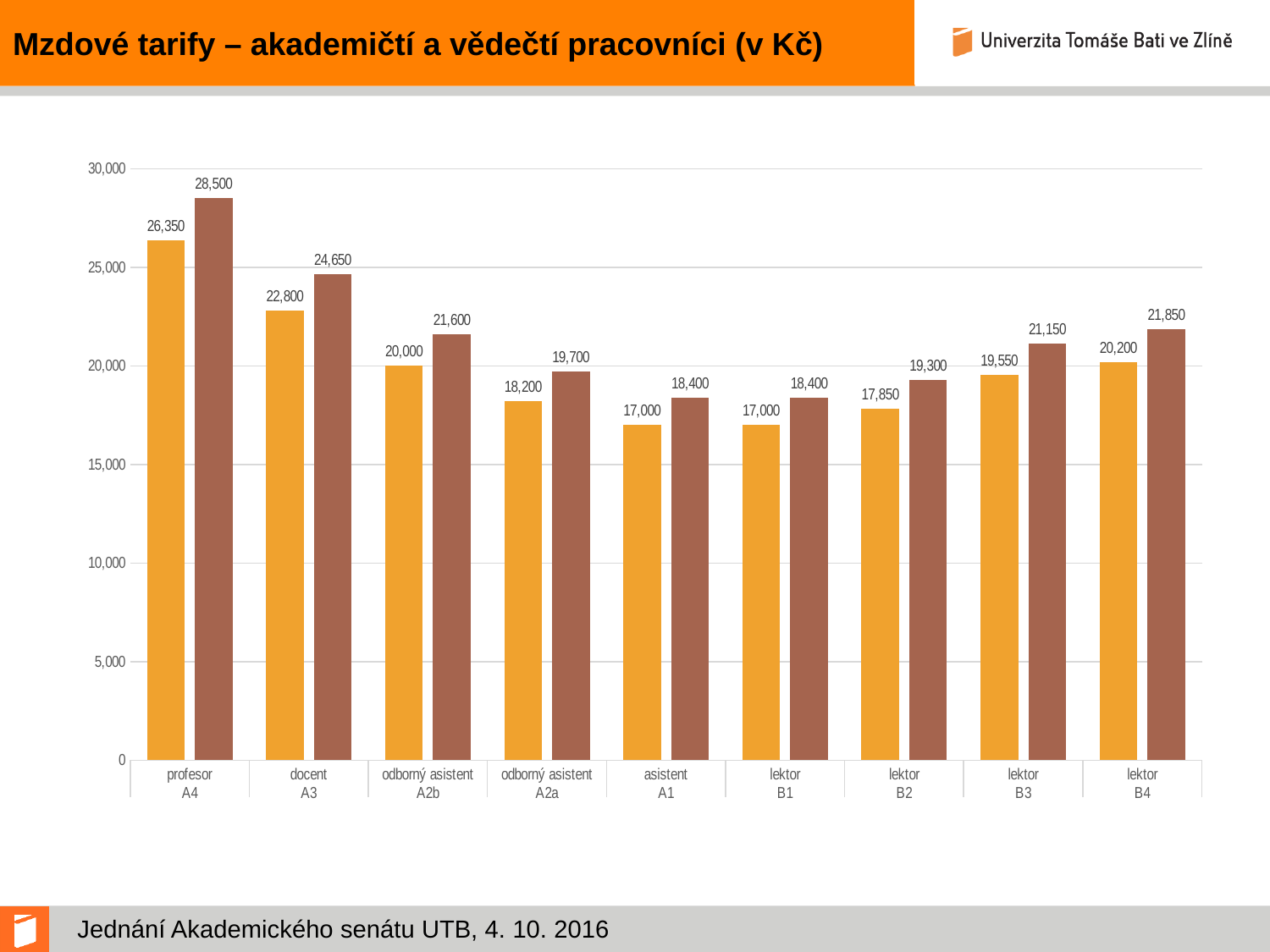
Which category has the lowest brown bar? asistent A1 and lektor B1 (both 18,400) Which category has the highest brown bar? profesor A4 Which is larger, the orange bar for odborný asistent A2b or the orange bar for lektor B4? lektor B4 What is the value of the brown bar for lektor B4? 21,850 What is the title of the slide containing the chart? Mzdové tarify – akademičtí a vědečtí pracovníci (v Kč) What is the value of the brown bar for docent A3? 24,650 What is the value of the orange bar for lektor B3? 19,550 What type of chart is shown on the slide? bar chart What is the difference between the brown and orange bars for profesor A4? 2,150 How many categories are shown on the x axis? 9 What is the difference between the orange bars for lektor B4 and lektor B2? 2,350 What is the value of the orange bar for profesor A4? 26,350